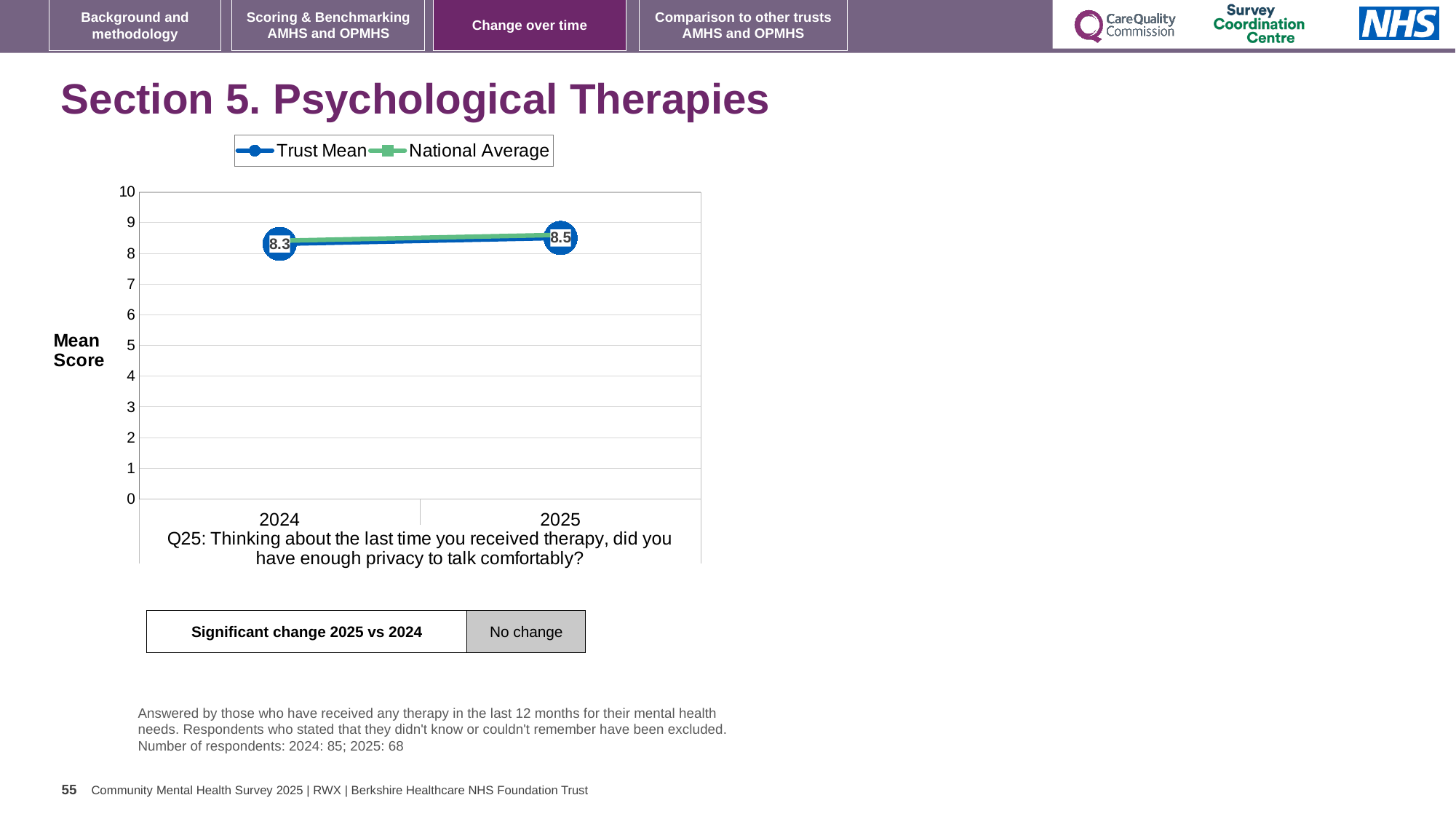
How many series does the legend list? 2 What is the Trust Mean score for 2024? 8.3 How many years are plotted on the x axis? 2 Does the Trust Mean rise or fall from 2024 to 2025? rise What are the two series named in the chart legend? Trust Mean and National Average By how much did the Trust Mean change from 2024 to 2025? 0.2 Is the Trust Mean value for 2025 greater or less than 8? greater Which year has the lowest Trust Mean score? 2024 Is the National Average value for 2024 greater or less than 5? greater What kind of chart is shown on the slide? line chart Which year has the higher Trust Mean score, 2024 or 2025? 2025 What is the Trust Mean score for 2025? 8.5